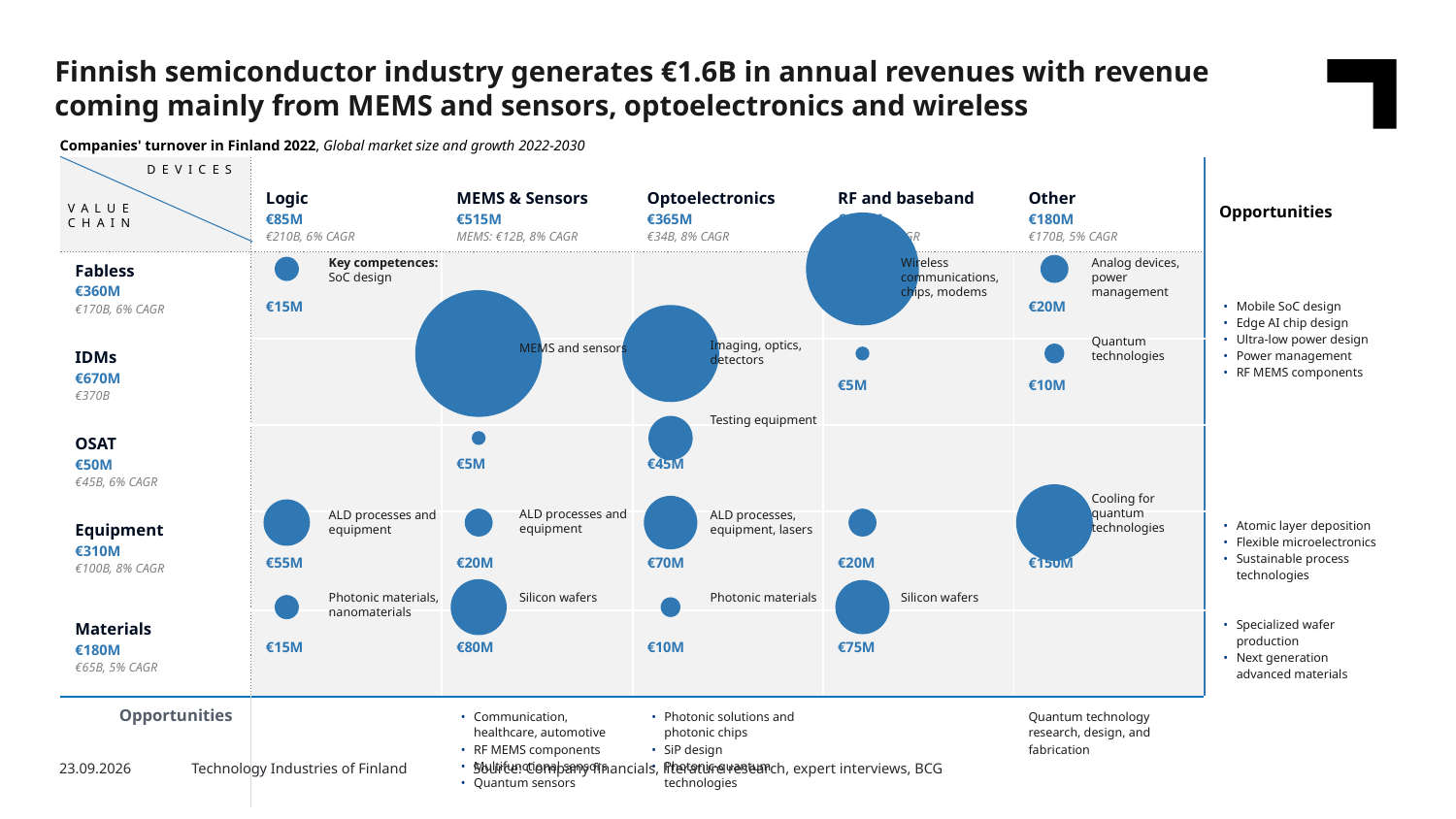
What global market size and CAGR are shown for the Equipment segment? €100B, 8% CAGR Which is larger: the Materials / MEMS & Sensors value or the Materials / RF and baseband value? Materials / MEMS & Sensors What is the difference between the Equipment / Optoelectronics value and the Equipment / MEMS & Sensors value? €50M Which value chain segment has the lowest turnover? OSAT What is the value of the Materials / MEMS & Sensors cell (silicon wafers)? €80M How many value chain segments are listed as rows in the chart? 5 What kind of chart is used to show the turnover by device and value chain segment? Bubble chart What is the turnover shown for MEMS & Sensors devices? €515M Which value chain segment has the highest turnover? IDMs What is the turnover for the Fabless segment in Finland in 2022? €360M How many device categories are listed as columns in the chart? 5 What is the value of the Equipment / Other cell (cooling for quantum technologies)? €150M